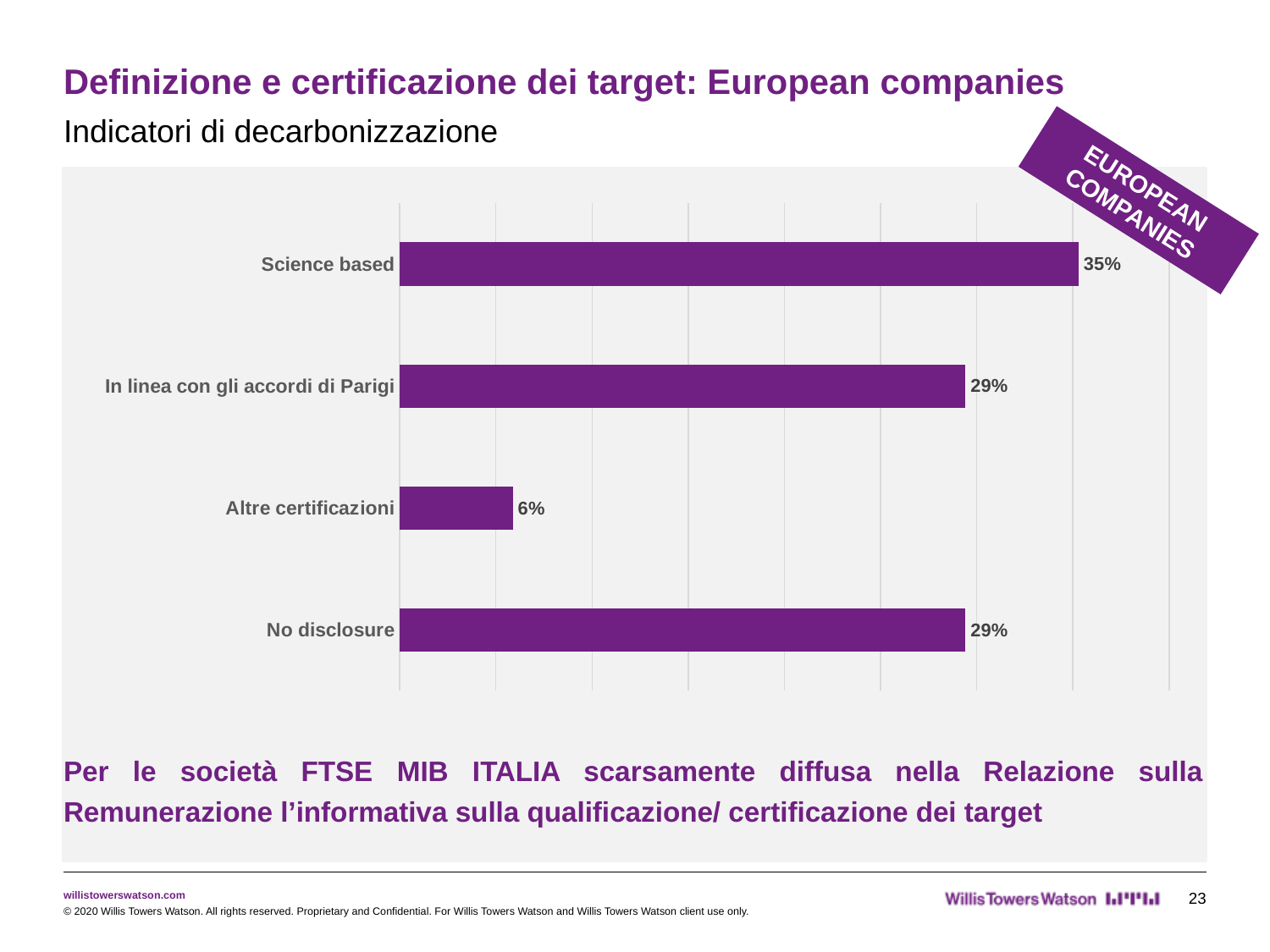
What is the value for Altre certificazioni? 6% Which is larger, the value for Science based or the value for In linea con gli accordi di Parigi? Science based Which category has the highest value? Science based Which category has the lowest value? Altre certificazioni What is the value for No disclosure? 29% What is the value for Science based? 35% What kind of chart is shown on the slide? Bar chart What is the value for In linea con gli accordi di Parigi? 29% What is the difference between the values for Science based and Altre certificazioni? 29% What is the difference between the values for Science based and No disclosure? 6% How many categories are shown in the chart? 4 What is the subtitle of the chart on the slide? Indicatori di decarbonizzazione